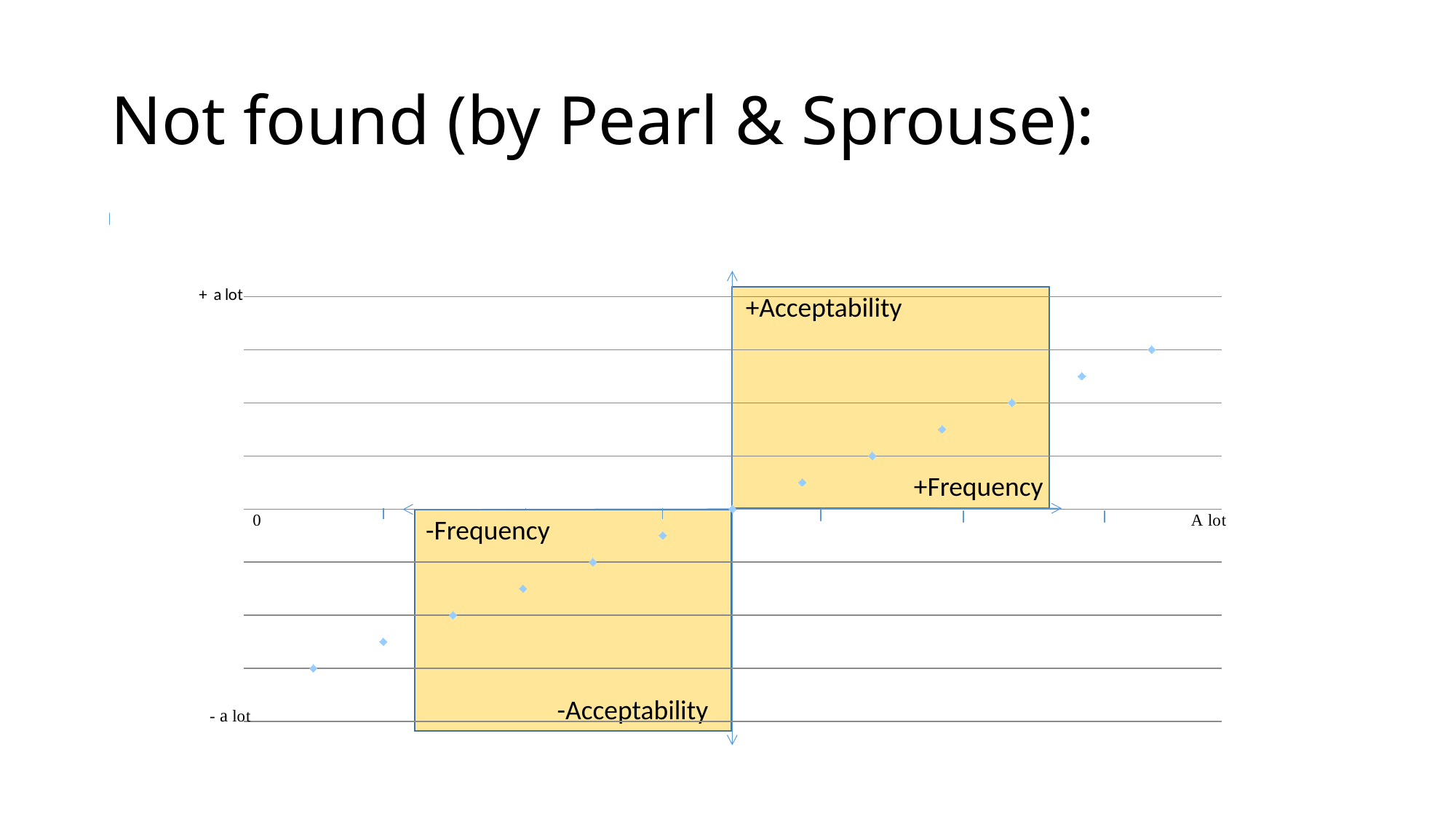
Are the points on the left half of the chart above or below the horizontal zero axis? below What is the title of the slide containing the chart? Not found (by Pearl & Sprouse): How many points lie in the upper-right (positive) region of the chart? 6 Are the points on the right half of the chart above or below the horizontal zero axis? above What kind of chart is shown on the slide? scatter chart Do the plotted points rise or fall as you move from left to right along the x axis? rise How many data points are plotted on the chart? 13 How many points lie in the lower-left (negative) region of the chart? 6 What label appears at the right end of the x axis? A lot